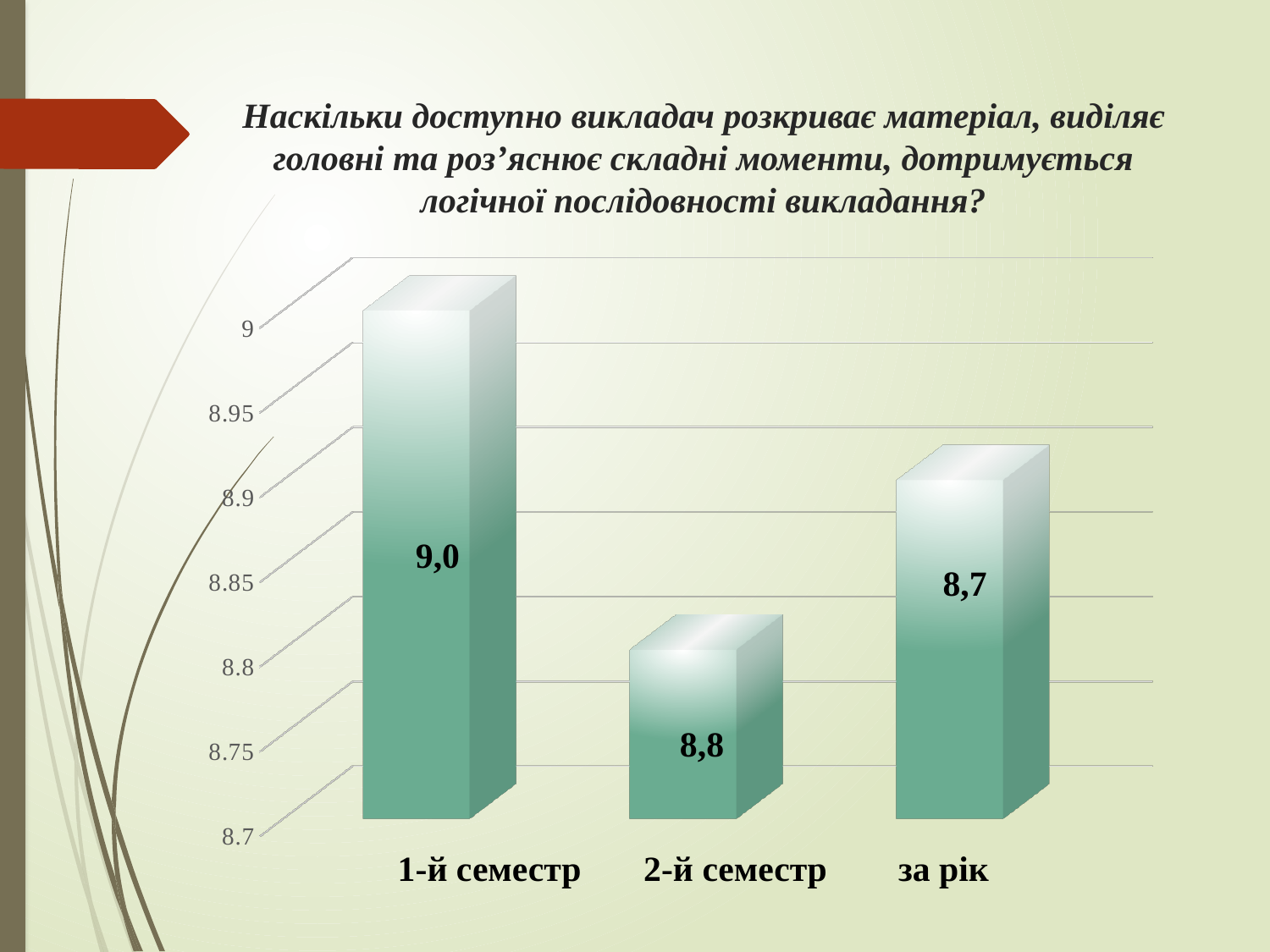
Which is larger, the value for 1-й семестр or the value for 2-й семестр? 1-й семестр What is the label of the third category on the x axis? за рік What kind of chart is shown on the slide? bar chart What is the value for 1-й семестр? 9,0 How many categories are shown on the x axis? 3 What is the value for 2-й семестр? 8,8 Is the value for 2-й семестр greater or less than 8.9? less What is the value for за рік? 8,7 What is the difference between the values for 1-й семестр and 2-й семестр? 0,2 Which category has the highest value? 1-й семестр Is the value for 1-й семестр greater or less than 8.9? greater What is the lowest value shown on the vertical axis? 8.7